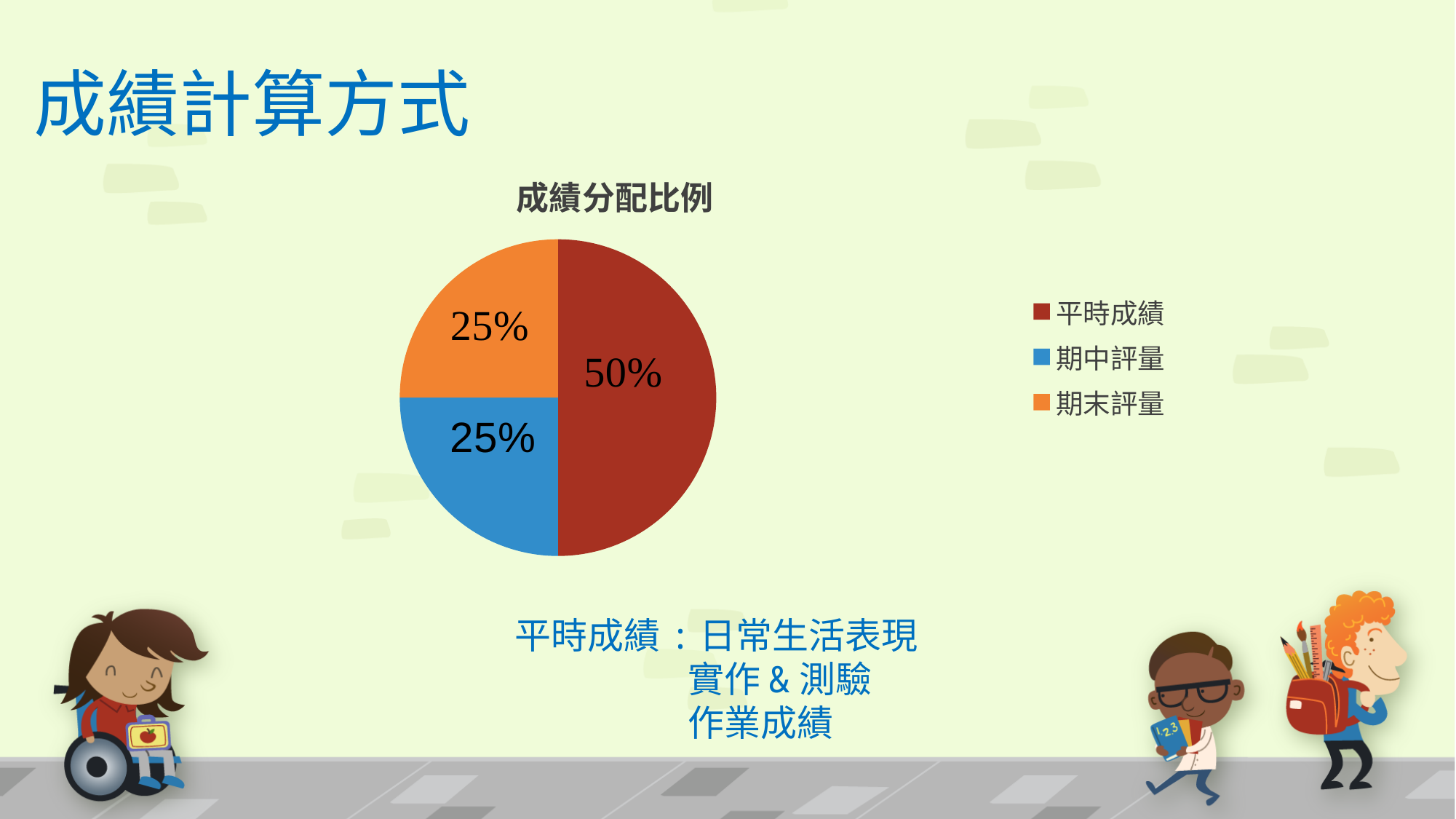
What is the difference between the share for 平時成績 and the share for 期中評量? 25% What is the combined share of 期中評量 and 期末評量? 50% Which is larger, the share for 平時成績 or the share for 期末評量? 平時成績 What share of the pie does 平時成績 take? 50% What type of chart is shown on the slide? pie chart How many slices does the pie chart have? 3 What share of the pie does 期中評量 take? 25% Which category has the largest slice of the pie? 平時成績 What colour is the slice for 期中評量? blue What is the title of the chart? 成績分配比例 What share of the pie does 期末評量 take? 25% How many entries does the legend list? 3